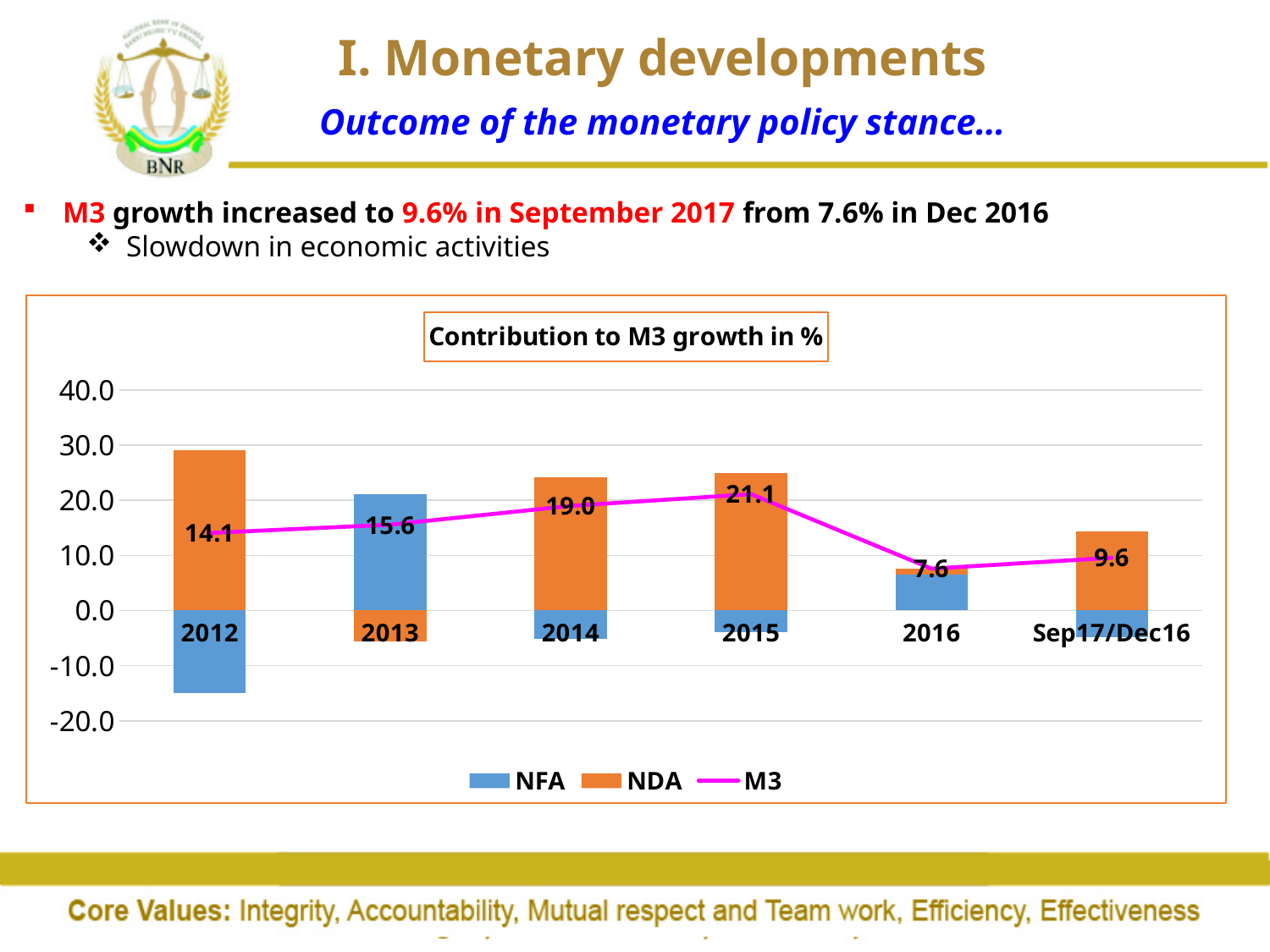
What is the M3 value for Sep17/Dec16? 9.6 What is the title of the chart? Contribution to M3 growth in % What is the M3 value for 2012? 14.1 What is the difference between the M3 values for 2015 and 2016? 13.5 How many categories are shown on the x axis? 6 In which category is the M3 line highest? 2015 Is the NFA value for 2012 greater or less than -10.0? less Is the NDA value for 2012 greater or less than 20.0? greater Which has a higher M3 value, 2013 or 2014? 2014 What is the M3 value for 2015? 21.1 How many series does the legend list? 3 In which category is the M3 line lowest? 2016